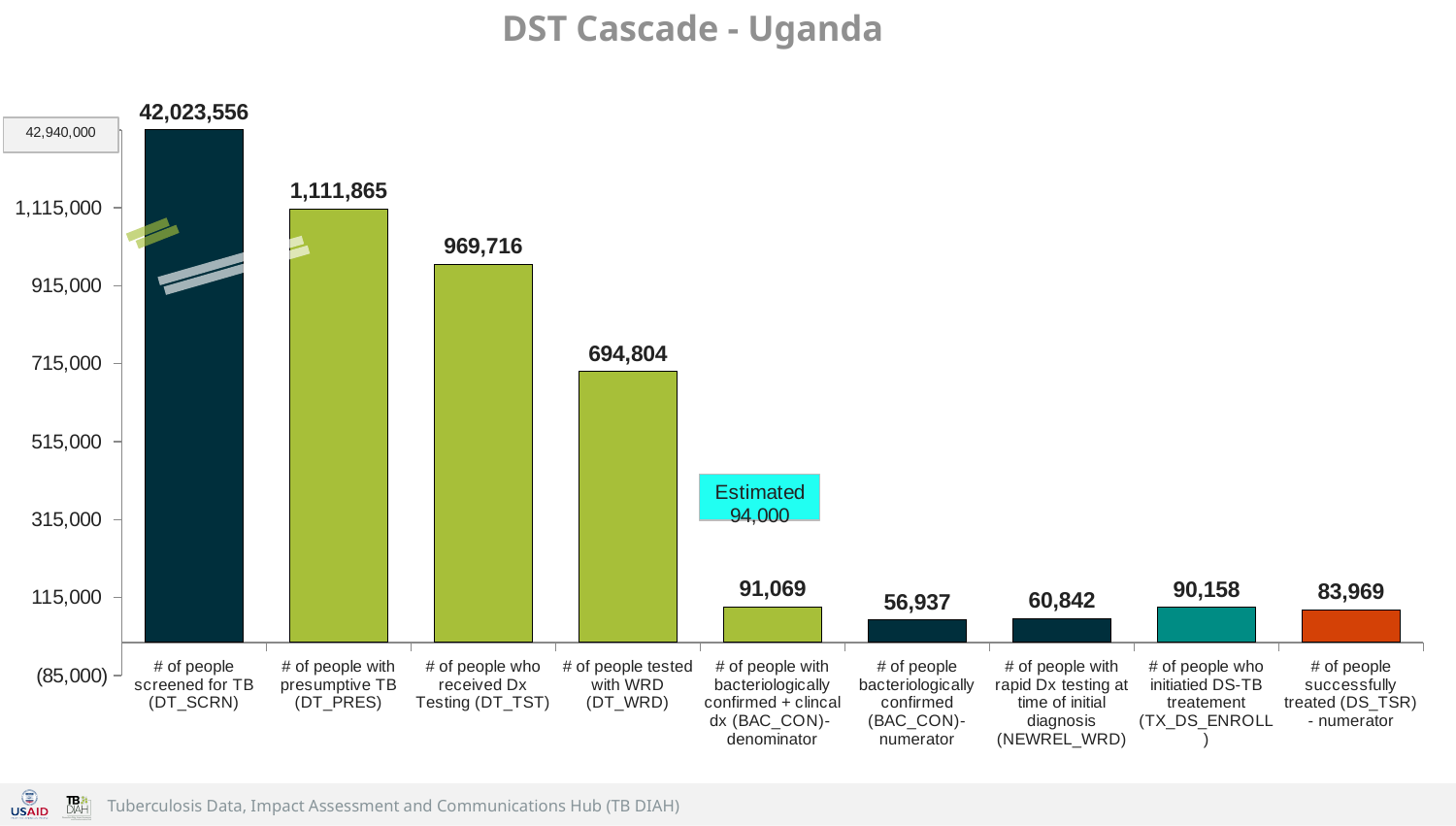
How many bars (categories) does the chart show? 9 Which category has the lowest value? # of people bacteriologically confirmed (BAC_CON)-numerator What is the value for # of people screened for TB (DT_SCRN)? 42,023,556 Which is larger: # of people who initiatied DS-TB treatement (TX_DS_ENROLL) or # of people successfully treated (DS_TSR) - numerator? # of people who initiatied DS-TB treatement (TX_DS_ENROLL) What is the title of the chart? DST Cascade - Uganda What is the value for # of people tested with WRD (DT_WRD)? 694,804 What is the value for # of people who initiatied DS-TB treatement (TX_DS_ENROLL)? 90,158 What estimated value is shown in the highlighted box above the BAC_CON denominator bar? Estimated 94,000 What is the difference between # of people with presumptive TB (DT_PRES) and # of people who received Dx Testing (DT_TST)? 142,149 Which category has the highest value? # of people screened for TB (DT_SCRN) What is the difference between # of people with bacteriologically confirmed + clincal dx (BAC_CON)-denominator and # of people bacteriologically confirmed (BAC_CON)-numerator? 34,132 What kind of chart is shown on the slide? bar chart